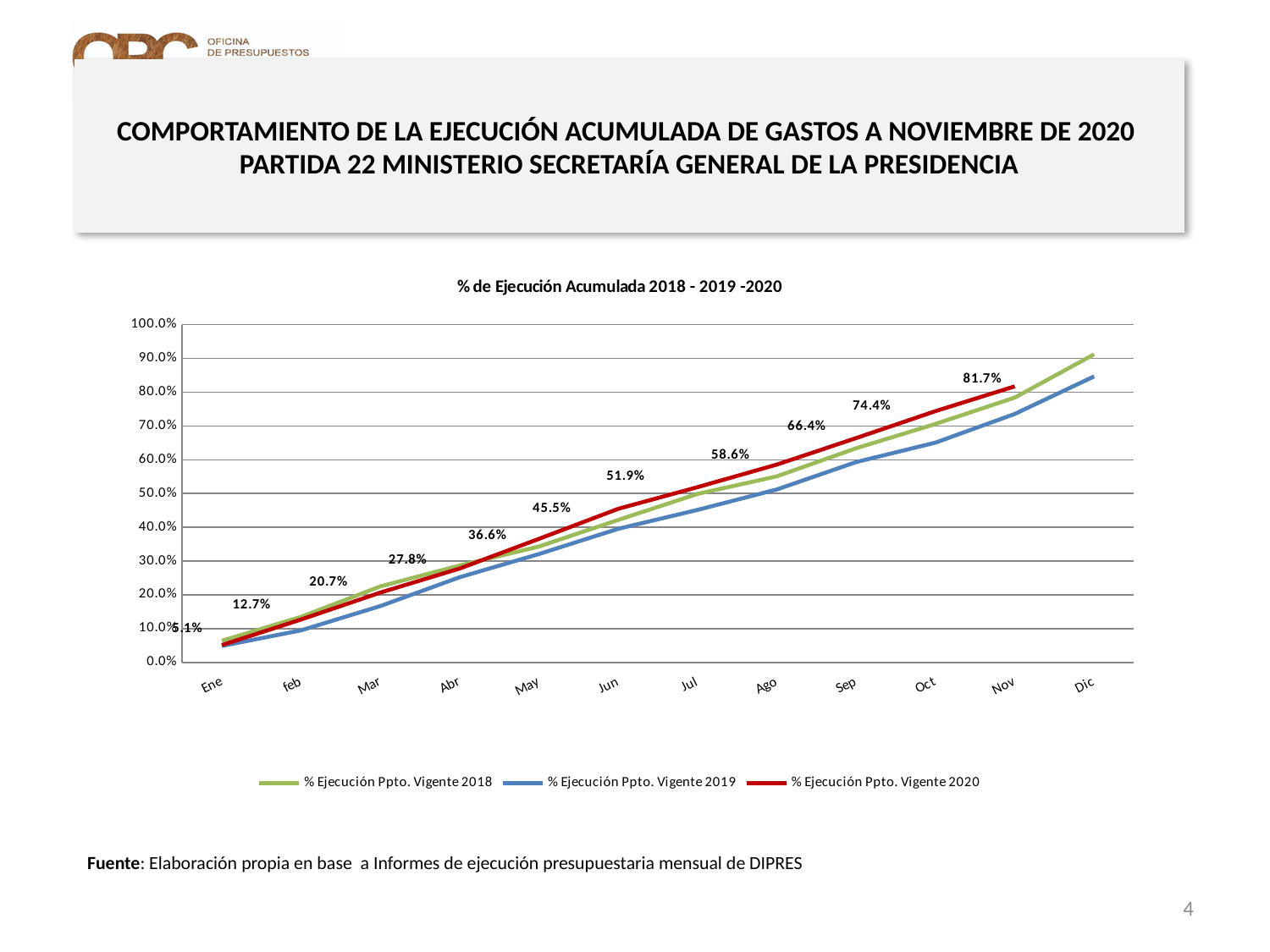
What is the value of % Ejecución Ppto. Vigente 2020 in Nov? 81.7% Does the 2020 series rise or fall from Ene to Nov? rise What is the difference between the 2020 values for Nov and Ene? 76.6% What type of chart is shown on the slide? line chart In which month does the 2020 series reach its highest value? Nov How many series does the legend list? 3 What is the value of % Ejecución Ppto. Vigente 2020 in Mar? 20.7% In which month does the 2020 series have its lowest value? Ene What is the difference between the 2020 values for Oct and Sep? 8.0% What is the value of % Ejecución Ppto. Vigente 2020 in Jun? 45.5% What is the title of the chart? % de Ejecución Acumulada 2018 - 2019 -2020 Is the value of % Ejecución Ppto. Vigente 2019 in Dic greater or less than 80.0%? greater